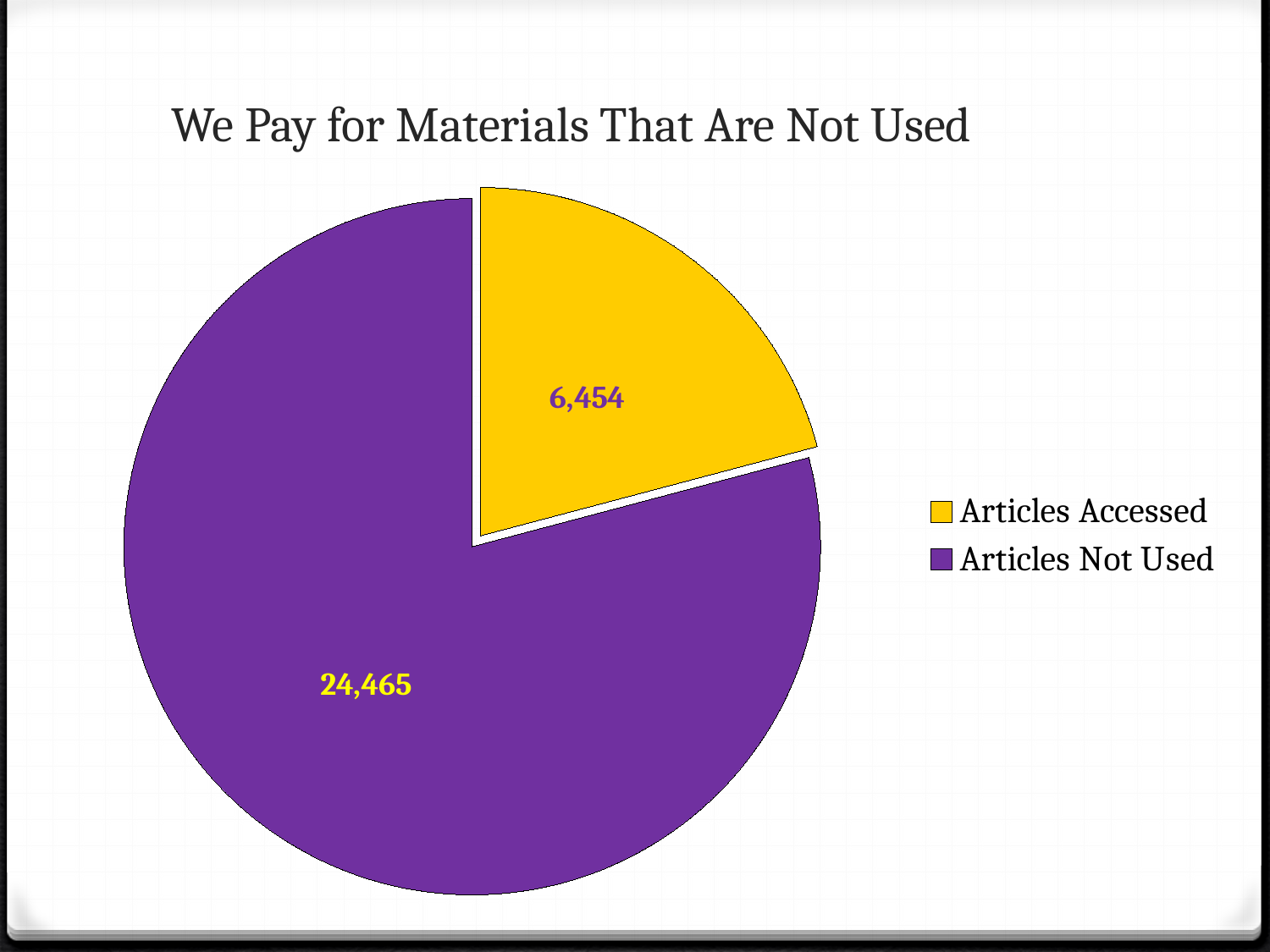
What is the title of the slide? We Pay for Materials That Are Not Used What value is shown for Articles Not Used? 24,465 What is the total of the two slices in the pie chart? 30,919 How many entries does the legend list? 2 Which slice of the pie is the largest? Articles Not Used What value is shown for Articles Accessed? 6,454 Which slice of the pie is the smallest? Articles Accessed What is the difference between Articles Not Used and Articles Accessed? 18,011 How many slices does the pie chart have? 2 Which is larger, Articles Accessed or Articles Not Used? Articles Not Used What kind of chart is shown on the slide? Pie chart